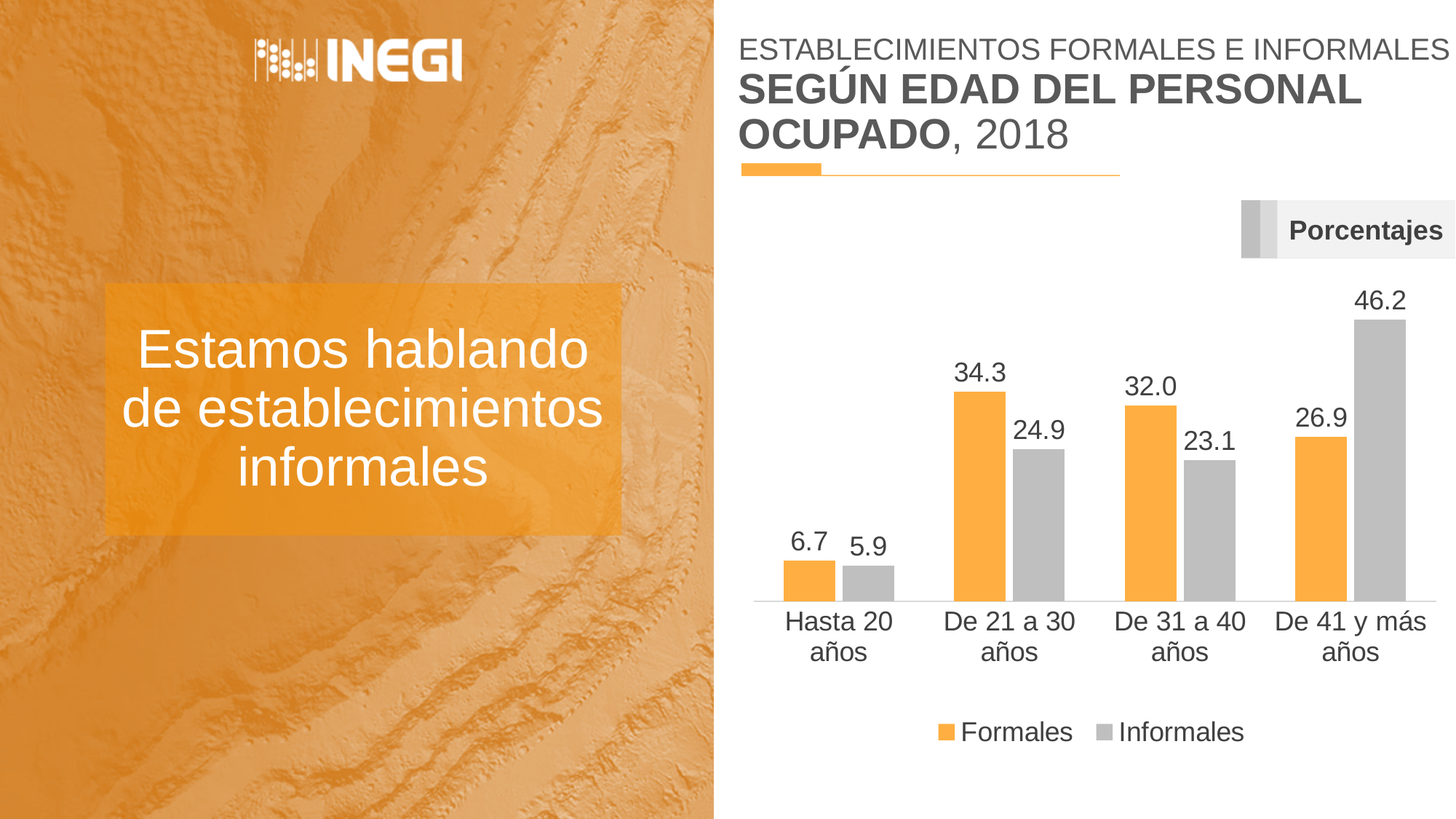
What is the difference between the Formales values for 'De 21 a 30 años' and 'De 31 a 40 años'? 2.3 How many series does the legend list? 2 Which age category has the lowest Formales value? Hasta 20 años What is the Informales value for 'De 41 y más años'? 46.2 What is the Informales value for 'Hasta 20 años'? 5.9 Which age category has the highest Informales value? De 41 y más años What is the Formales value for 'De 21 a 30 años'? 34.3 What kind of chart is shown on the slide? Bar chart For 'De 31 a 40 años', which is larger: Formales or Informales? Formales What unit label is shown in the box above the chart? Porcentajes How many age categories are shown on the x axis? 4 What is the difference between the Informales and Formales values for 'De 41 y más años'? 19.3